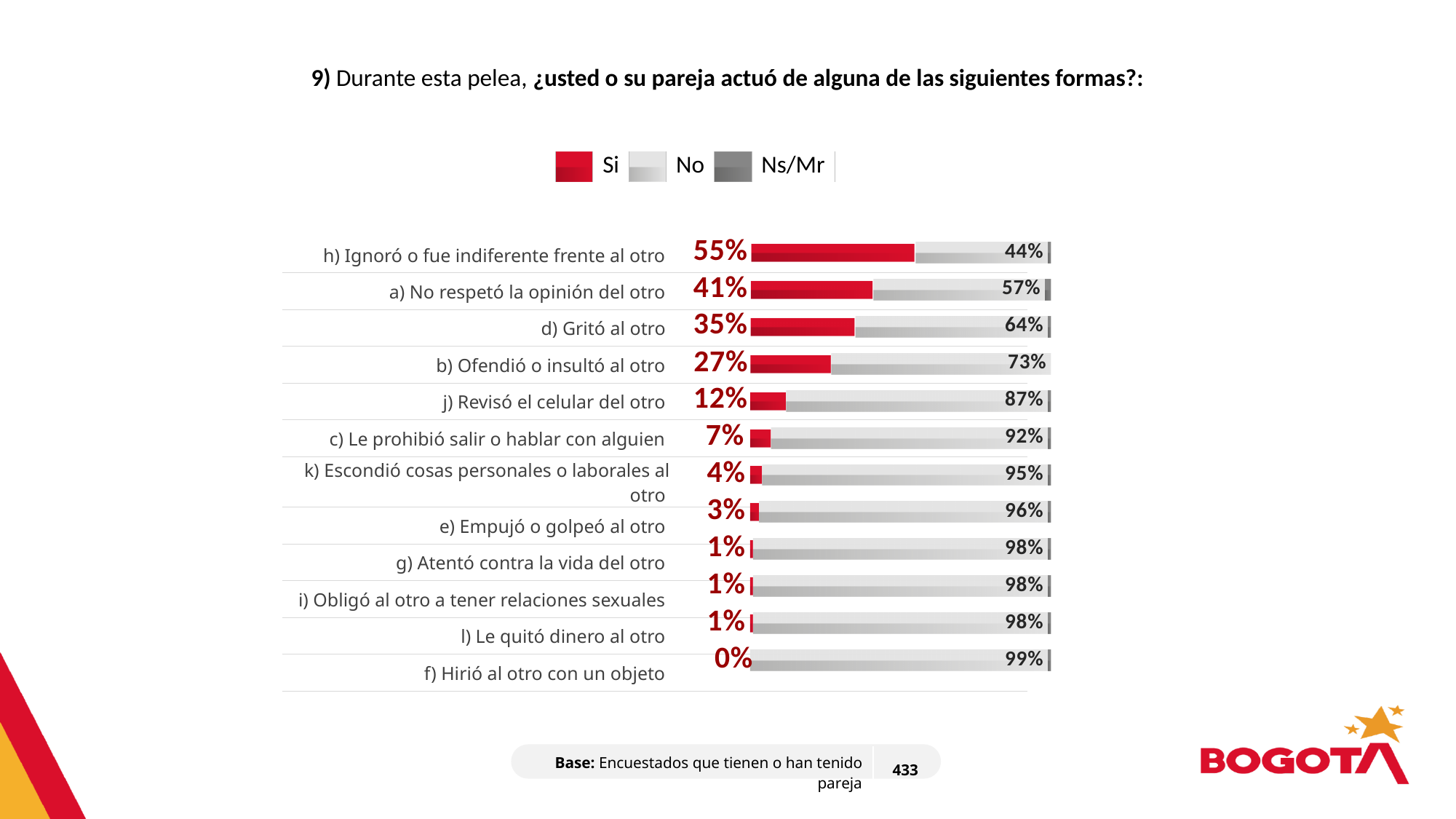
What is the "No" value for "b) Ofendió o insultó al otro"? 73% What is the base (number of respondents) shown for the chart? 433 What percentage answered "Si" for "h) Ignoró o fue indiferente frente al otro"? 55% Which has a larger "Si" value: "c) Le prohibió salir o hablar con alguien" or "k) Escondió cosas personales o laborales al otro"? c) Le prohibió salir o hablar con alguien Which category has the highest "Si" percentage? h) Ignoró o fue indiferente frente al otro What kind of chart is shown on the slide? Stacked bar chart What is the difference between the "Si" values for "a) No respetó la opinión del otro" and "d) Gritó al otro"? 6% What percentage answered "No" for "d) Gritó al otro"? 64% What is the "Si" value for "j) Revisó el celular del otro"? 12% How many categories are shown in the chart? 12 How many series does the legend list? 3 Which category has the lowest "Si" percentage? f) Hirió al otro con un objeto